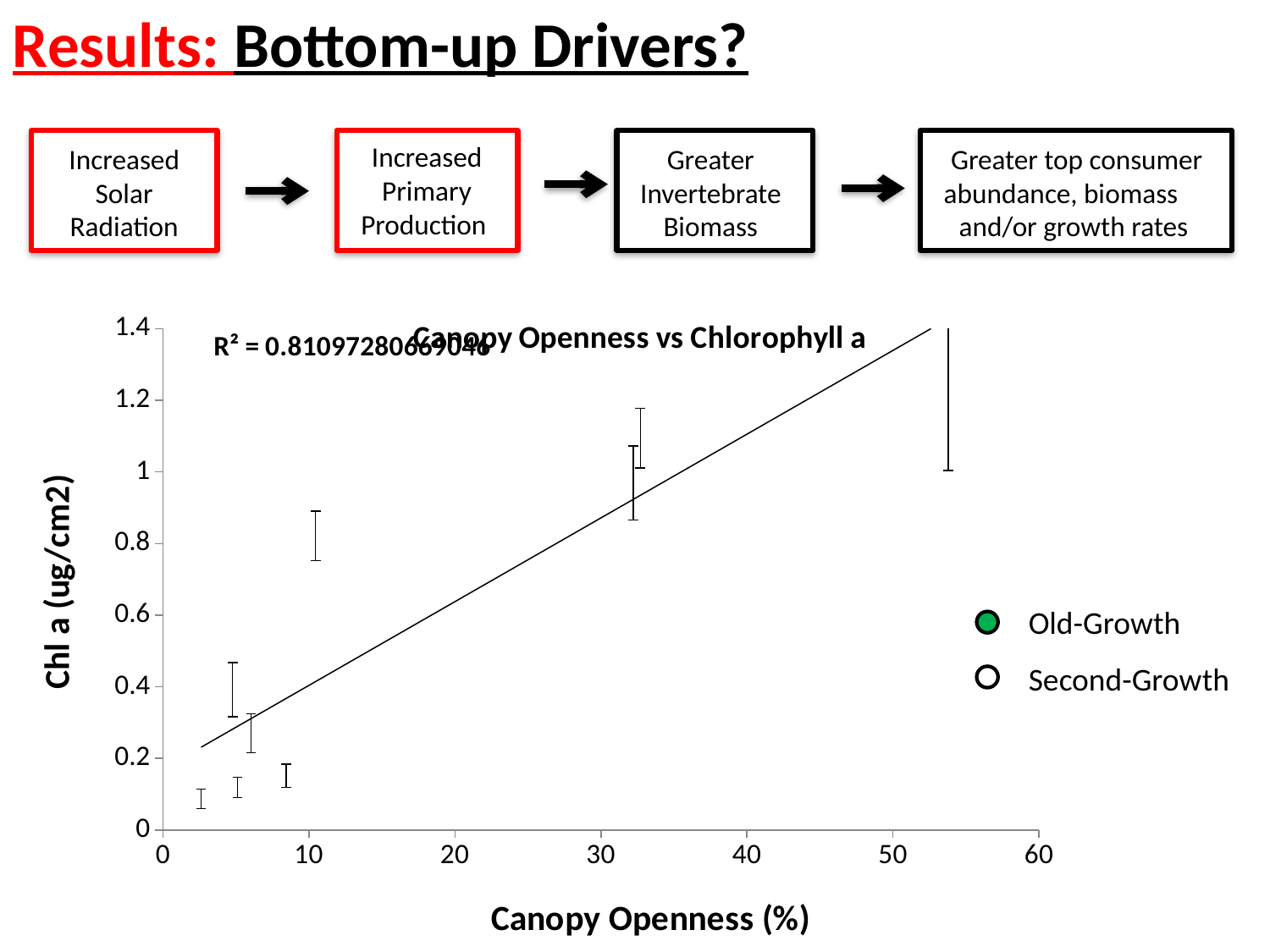
What is the highest value shown on the x axis of the chart? 60 How many data points (error bars) are plotted on the chart? 9 What is the title of the chart? Canopy Openness vs Chlorophyll a Is the canopy openness of the leftmost data point greater or less than 10? less What is the label of the x axis of the chart? Canopy Openness (%) Is the canopy openness of the rightmost data point greater or less than 50? greater Which legend entry is shown with a filled green marker? Old-Growth What is the highest value shown on the y axis of the chart? 1.4 What kind of chart is shown on the slide? Scatter chart Does chlorophyll a rise or fall as canopy openness increases along the x axis, according to the trendline? Rise How many series does the chart legend list? 2 What is the label of the y axis of the chart? Chl a (ug/cm2)